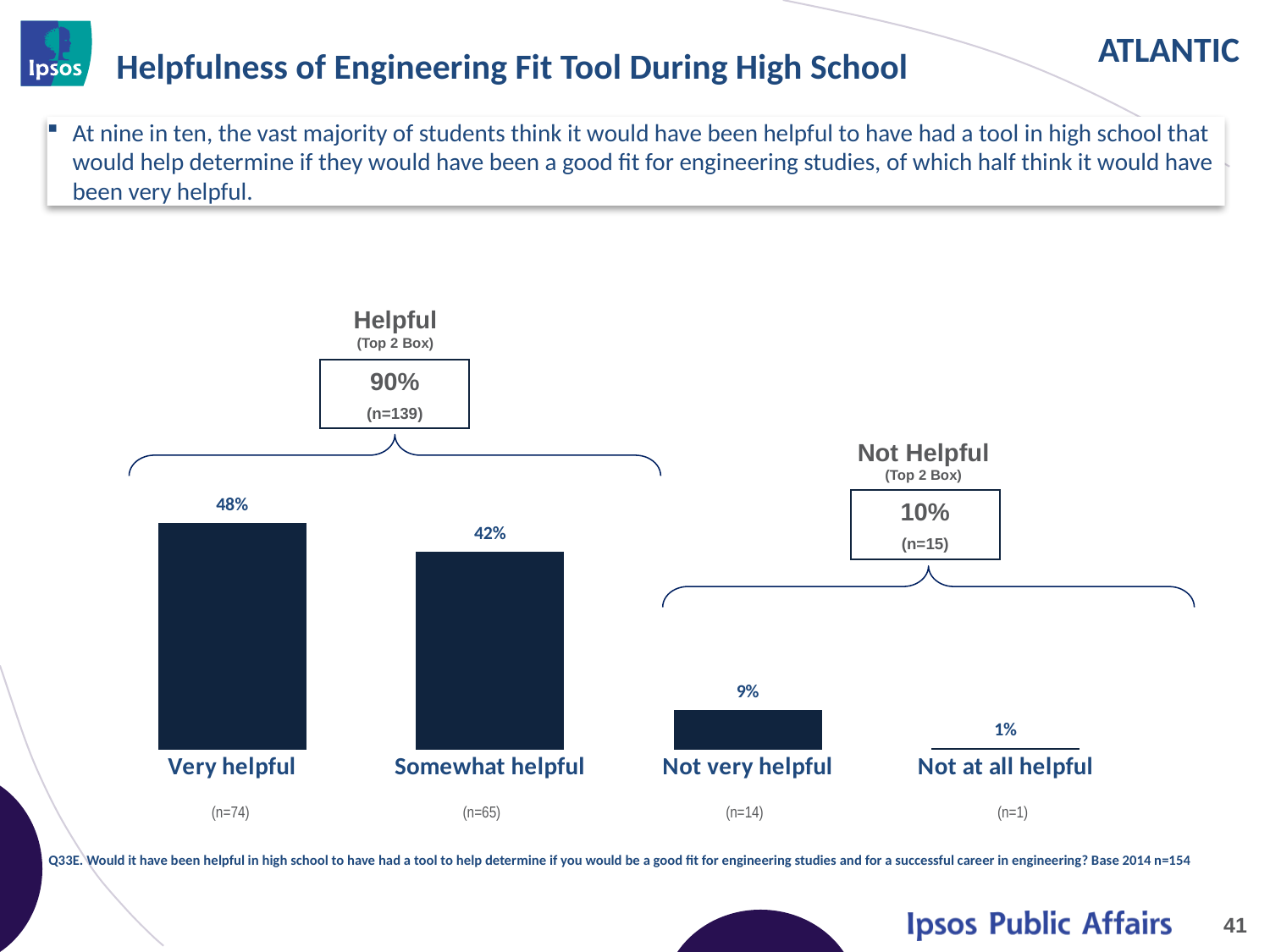
Which is larger, the value for Somewhat helpful or the value for Not very helpful? Somewhat helpful What is the Helpful (Top 2 Box) percentage shown above the chart? 90% What percentage of students said the tool would have been not at all helpful? 1% How many categories are shown in the chart? 4 What is the difference in percentage points between Very helpful and Somewhat helpful? 6 What percentage of students said the tool would have been somewhat helpful? 42% Which category has the highest percentage? Very helpful What percentage of students said the tool would have been not very helpful? 9% Which category has the lowest percentage? Not at all helpful What kind of chart is shown on the slide? Bar chart What percentage of students said the tool would have been very helpful? 48% What is the sample size (n) shown for the Not Helpful (Top 2 Box) group? n=15